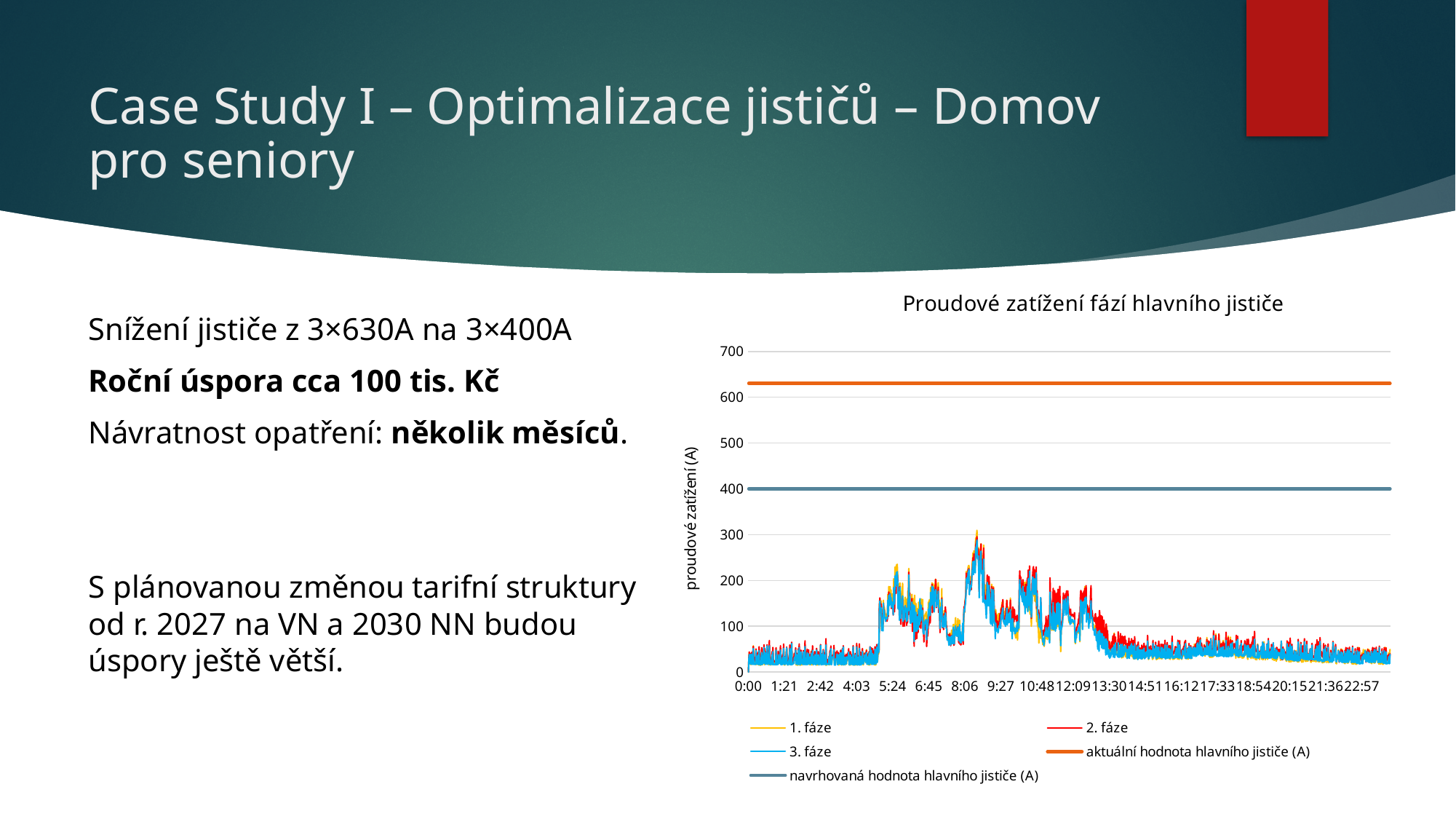
What is the title of the chart? Proudové zatížení fází hlavního jističe Is the value of the 'aktuální hodnota hlavního jističe (A)' line greater or less than 600? greater Is the value of the 'aktuální hodnota hlavního jističe (A)' line greater or less than 700? less What is the value of the 'navrhovaná hodnota hlavního jističe (A)' line? 400 Are the phase load values around 22:57 higher or lower than around 8:06? lower Is the highest peak of the phase load lines (1., 2., 3. fáze) greater or less than 400? less How many series does the legend of the chart list? 5 What kind of chart is shown on the slide? line chart What is the label of the vertical axis of the chart? proudové zatížení (A) Which line is higher: 'aktuální hodnota hlavního jističe (A)' or 'navrhovaná hodnota hlavního jističe (A)'? aktuální hodnota hlavního jističe (A)